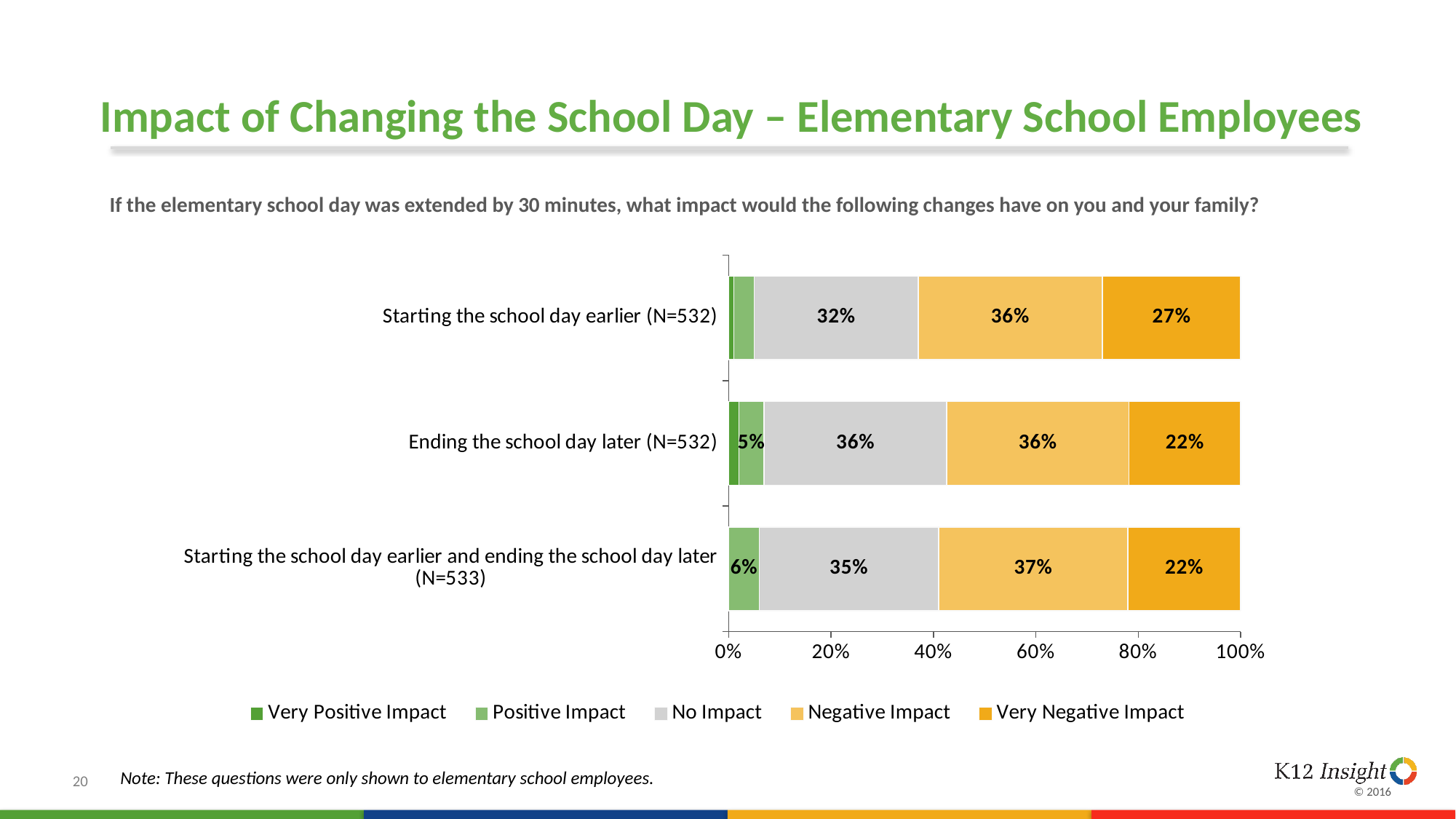
Which category has the lowest No Impact value? Starting the school day earlier (N=532) What kind of chart is shown on the slide? Stacked bar chart Which legend entry is shown in grey? No Impact What is the Negative Impact value for 'Starting the school day earlier and ending the school day later (N=533)'? 37% Which category has the highest Very Negative Impact value? Starting the school day earlier (N=532) What is the Positive Impact value for 'Ending the school day later (N=532)'? 5% Which is larger: the Positive Impact value for 'Ending the school day later (N=532)' or for 'Starting the school day earlier and ending the school day later (N=533)'? Starting the school day earlier and ending the school day later (N=533) How many series does the legend list? 5 What is the Very Negative Impact value for 'Starting the school day earlier (N=532)'? 27% How many categories are shown on the chart? 3 What is the difference between the Very Negative Impact values for 'Starting the school day earlier (N=532)' and 'Ending the school day later (N=532)'? 5% What is the No Impact value for 'Ending the school day later (N=532)'? 36%